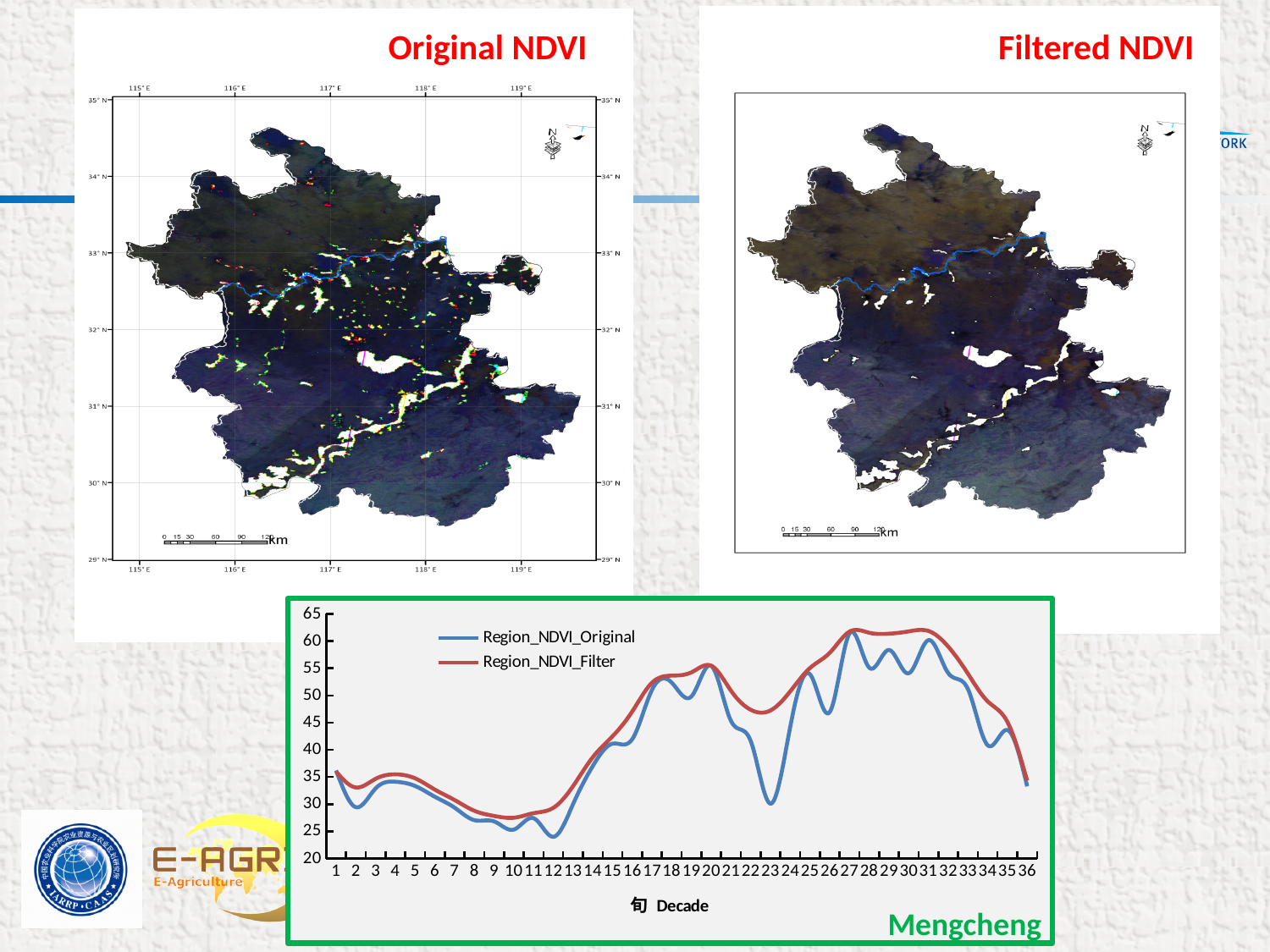
In the line chart, which series has the higher value at decade 23, Region_NDVI_Original or Region_NDVI_Filter? Region_NDVI_Filter In the line chart, is the value of Region_NDVI_Filter at decade 23 greater or less than 40? greater How many decades (points) are shown along the x axis of the line chart? 36 What is the label of the x axis of the line chart? 旬 Decade What kind of chart is the chart at the bottom of the slide? line chart In the line chart, do the values of Region_NDVI_Original rise or fall from decade 31 to decade 36? fall In the line chart, is the value of Region_NDVI_Original at decade 12 greater or less than 30? less In the line chart, is the value of Region_NDVI_Original at decade 23 greater or less than 40? less In the line chart, do the values of Region_NDVI_Filter rise or fall from decade 12 to decade 17? rise How many series does the legend of the line chart list? 2 What are the two series named in the legend of the line chart? Region_NDVI_Original and Region_NDVI_Filter